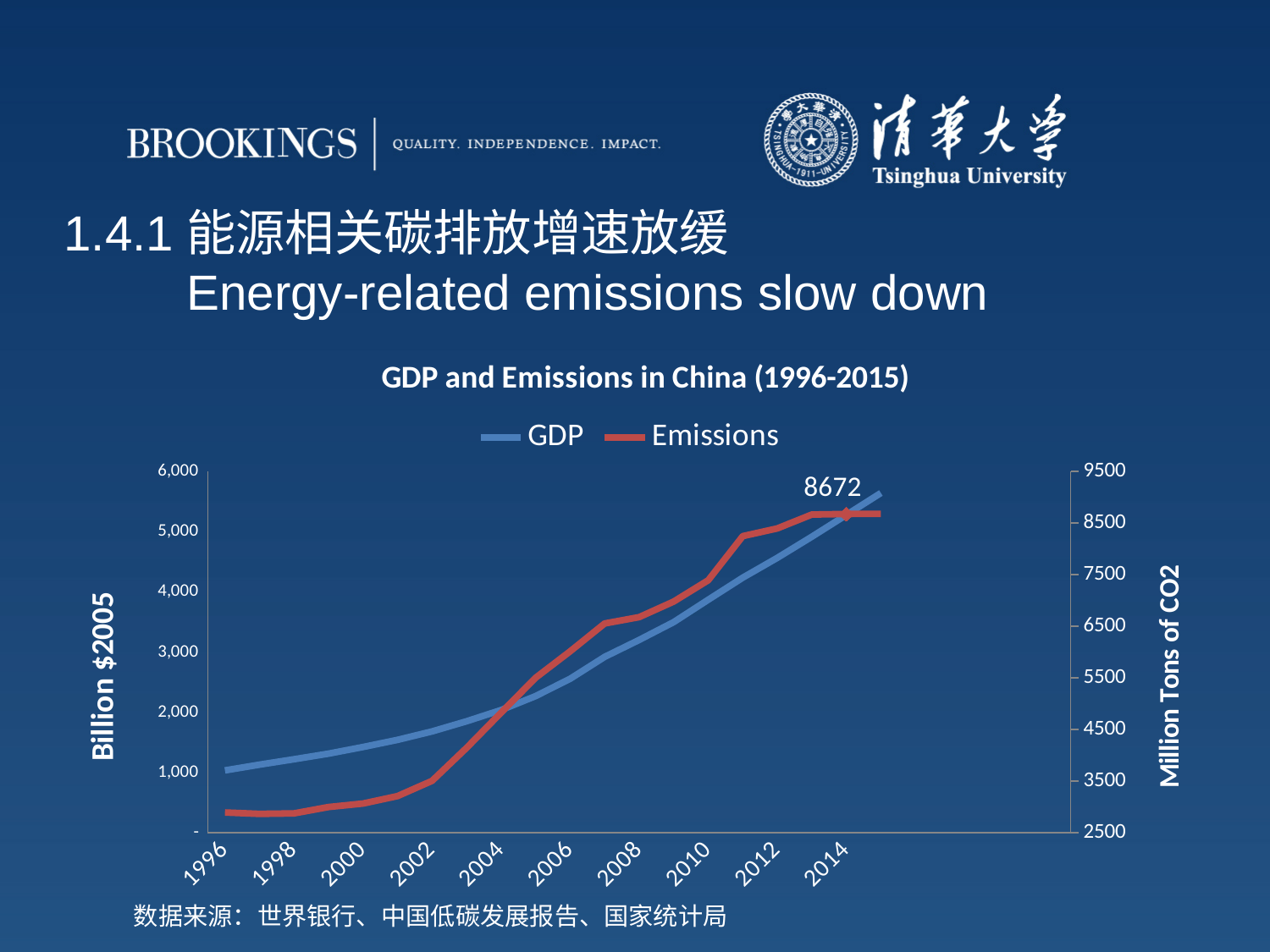
What type of chart is shown on the slide? Line chart How many year labels are shown on the x axis of the chart? 10 Which series carries the data label 8672? Emissions Is the Emissions value for 1996 greater or less than 3500? less Is the GDP value for 2006 greater or less than 2,000? greater What is the title of the chart? GDP and Emissions in China (1996-2015) What is the label of the right-hand vertical axis of the chart? Million Tons of CO2 Does the GDP line rise or fall from 1996 to 2015? Rise How many series does the legend of the chart list? 2 Does the Emissions line generally rise or fall across the period shown? Rise What value is printed as a data label on the Emissions line? 8672 Is the GDP value for 2014 greater or less than 5,000? greater